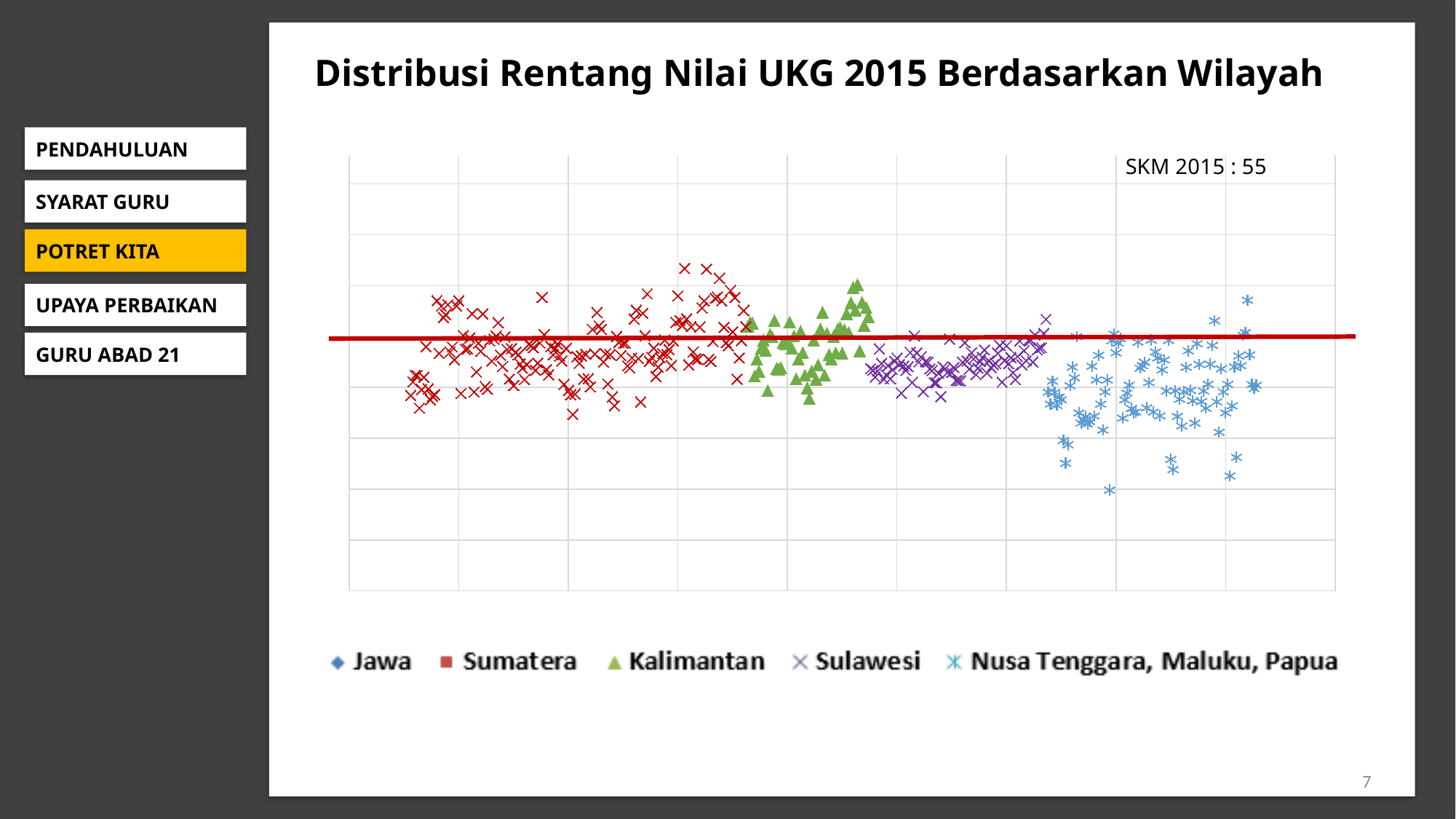
Do the plotted values generally rise or fall from left to right across the chart? fall What kind of chart is shown on the slide? scatter chart Which series contains the lowest plotted point on the chart? Nusa Tenggara, Maluku, Papua What is the title of the chart? Distribusi Rentang Nilai UKG 2015 Berdasarkan Wilayah Which series has its points mostly below the red horizontal line: Kalimantan or Nusa Tenggara, Maluku, Papua? Nusa Tenggara, Maluku, Papua What SKM 2015 value is annotated on the chart? 55 How many series does the legend list? 5